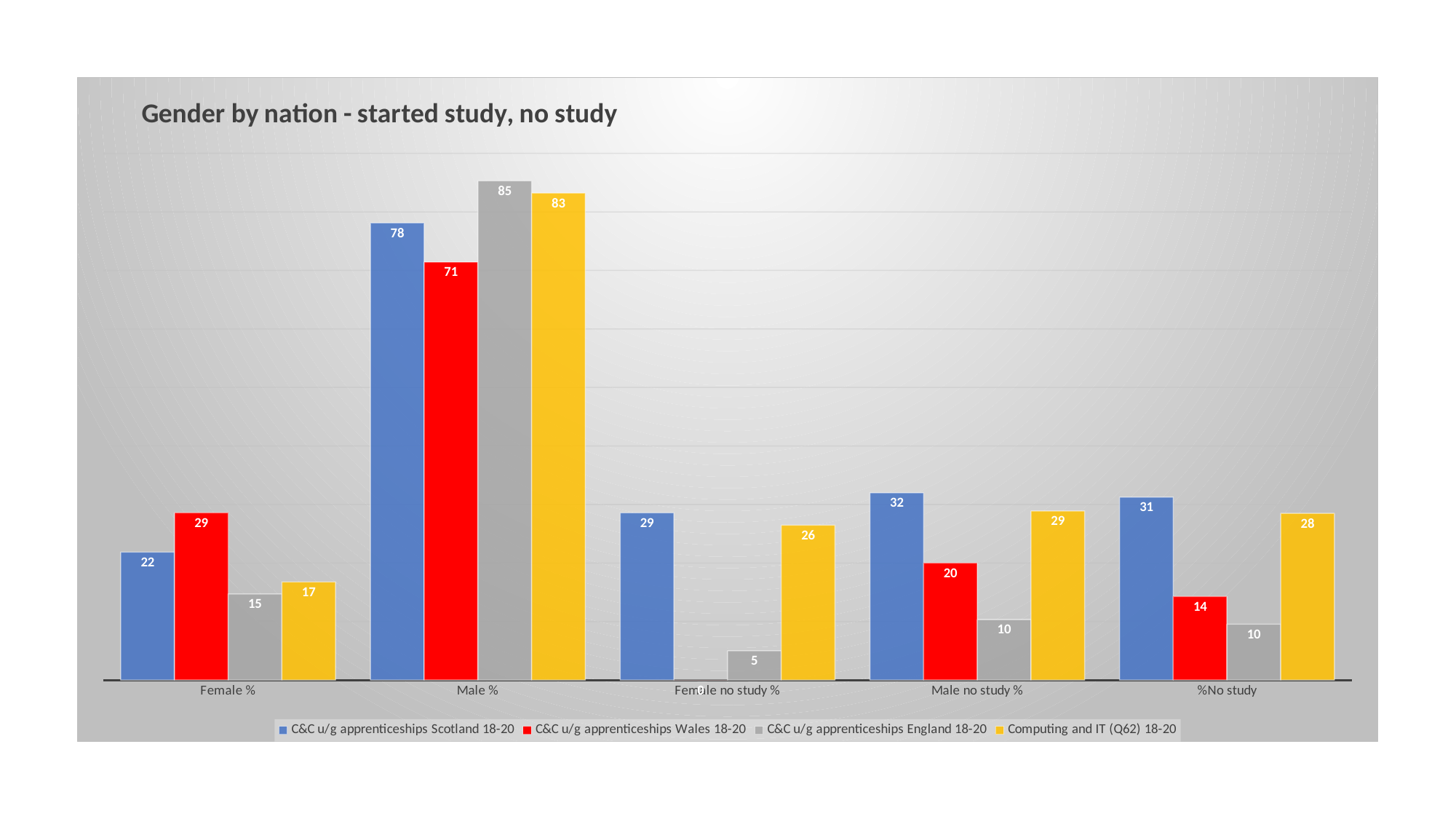
What is the value for C&C u/g apprenticeships England 18-20 in the Female no study % category? 5 What is the value for C&C u/g apprenticeships Scotland 18-20 in the Male % category? 78 In the %No study category, which is larger: the value for Scotland or the value for Computing and IT (Q62) 18-20? Scotland What is the value for Computing and IT (Q62) 18-20 in the Female % category? 17 How many categories are shown on the x axis? 5 What kind of chart is shown on the slide? Bar chart Which series has the lowest value in the Female % category? C&C u/g apprenticeships England 18-20 How many series does the legend list? 4 What colour are the bars for C&C u/g apprenticeships Wales 18-20? Red Which series has the highest value in the Male % category? C&C u/g apprenticeships England 18-20 What is the difference between the Scotland and Wales values in the Male no study % category? 12 What is the title of the chart? Gender by nation - started study, no study